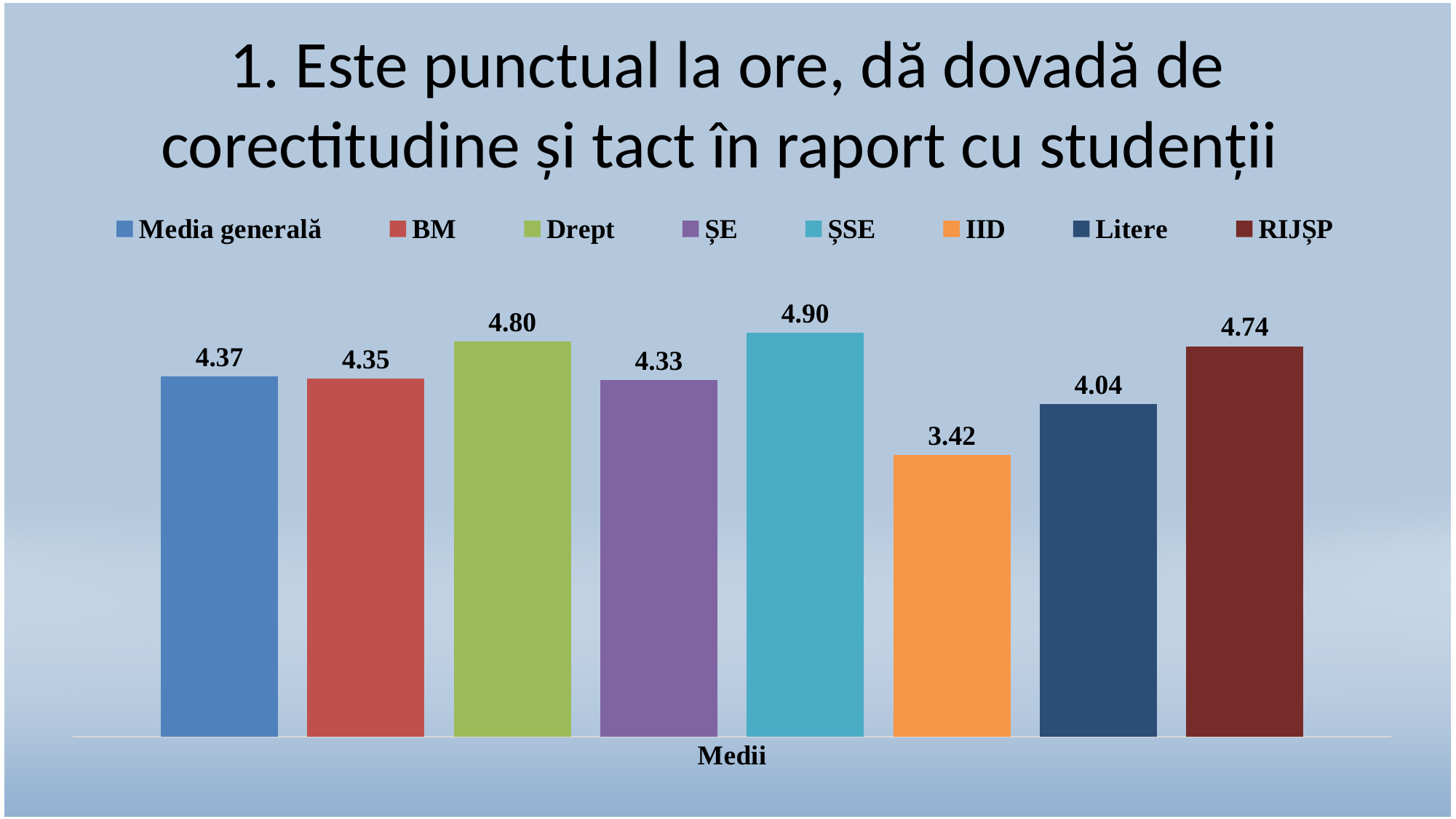
What is the value for IID? 3.42 What is the value for Drept? 4.80 What is the value for Media generală? 4.37 What is the label shown on the x axis? Medii Which is larger, the value for Drept or the value for RIJȘP? Drept Which series has the highest value? ȘSE Which series has the lowest value? IID What is the difference between the values for RIJȘP and Litere? 0.70 What is the value for Litere? 4.04 What kind of chart is shown on the slide? Bar chart What is the difference between the values for ȘSE and IID? 1.48 How many series does the legend list? 8